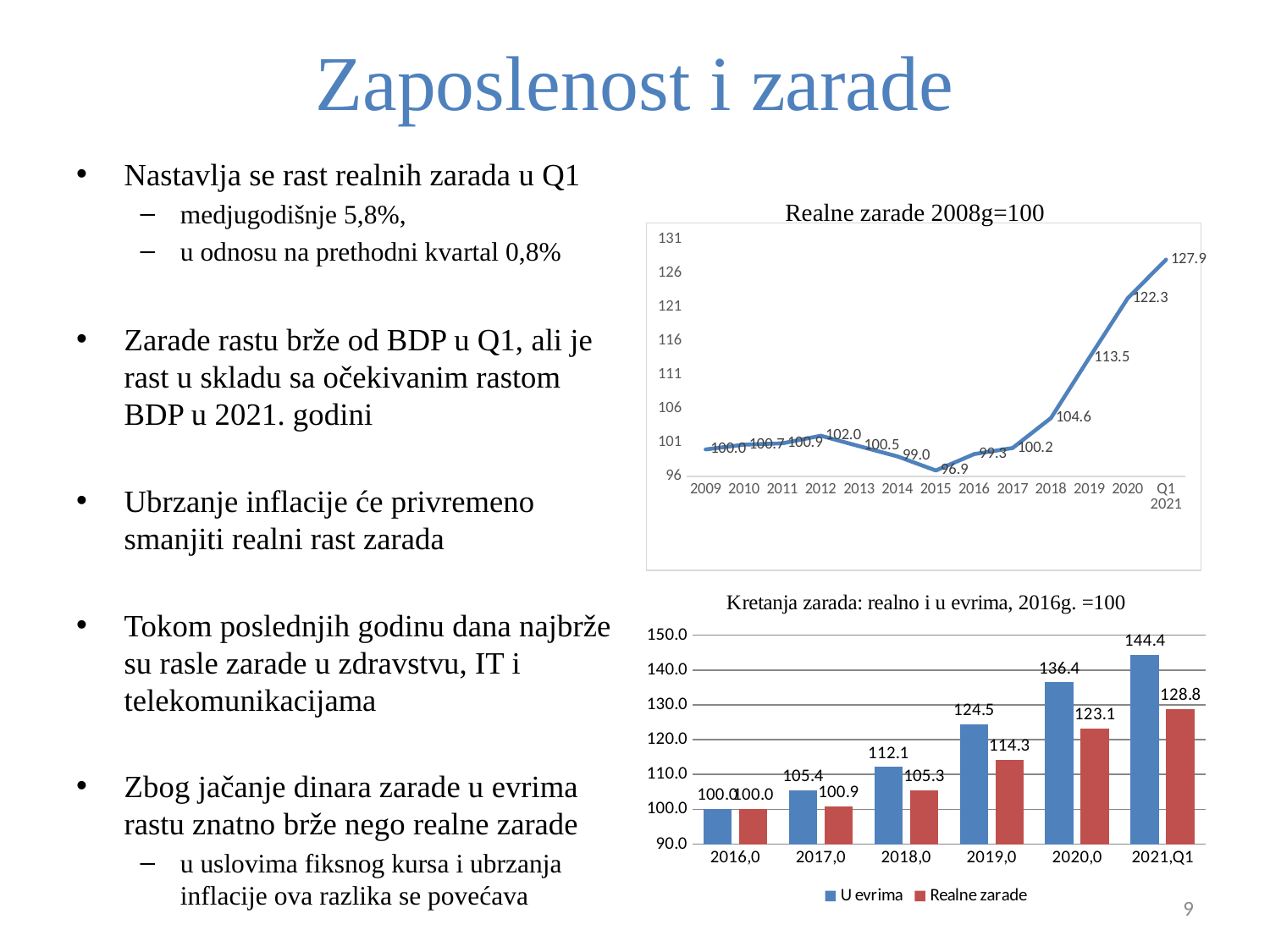
In the chart titled 'Kretanja zarada: realno i u evrima, 2016g. =100', what is the 'U evrima' value for 2019,0? 124.5 In the chart titled 'Kretanja zarada: realno i u evrima, 2016g. =100', how many series does the legend list? 2 In the chart titled 'Kretanja zarada: realno i u evrima, 2016g. =100', what is the 'Realne zarade' value for 2021,Q1? 128.8 In the chart titled 'Realne zarade 2008g=100', what is the value for 2015? 96.9 In the chart titled 'Realne zarade 2008g=100', how many data points are plotted? 13 In the chart titled 'Realne zarade 2008g=100', do the values rise or fall from 2017 to Q1 2021? rise In the chart titled 'Kretanja zarada: realno i u evrima, 2016g. =100', what is the difference between 'U evrima' and 'Realne zarade' for 2020,0? 13.3 In the chart titled 'Realne zarade 2008g=100', what is the difference between the values for 2020 and 2019? 8.8 In the chart titled 'Realne zarade 2008g=100', which year has the lowest value? 2015 In the chart titled 'Realne zarade 2008g=100', what is the value for Q1 2021? 127.9 In the chart titled 'Kretanja zarada: realno i u evrima, 2016g. =100', which is larger for 2018,0: 'U evrima' or 'Realne zarade'? U evrima What kind of chart is the one titled 'Realne zarade 2008g=100'? line chart